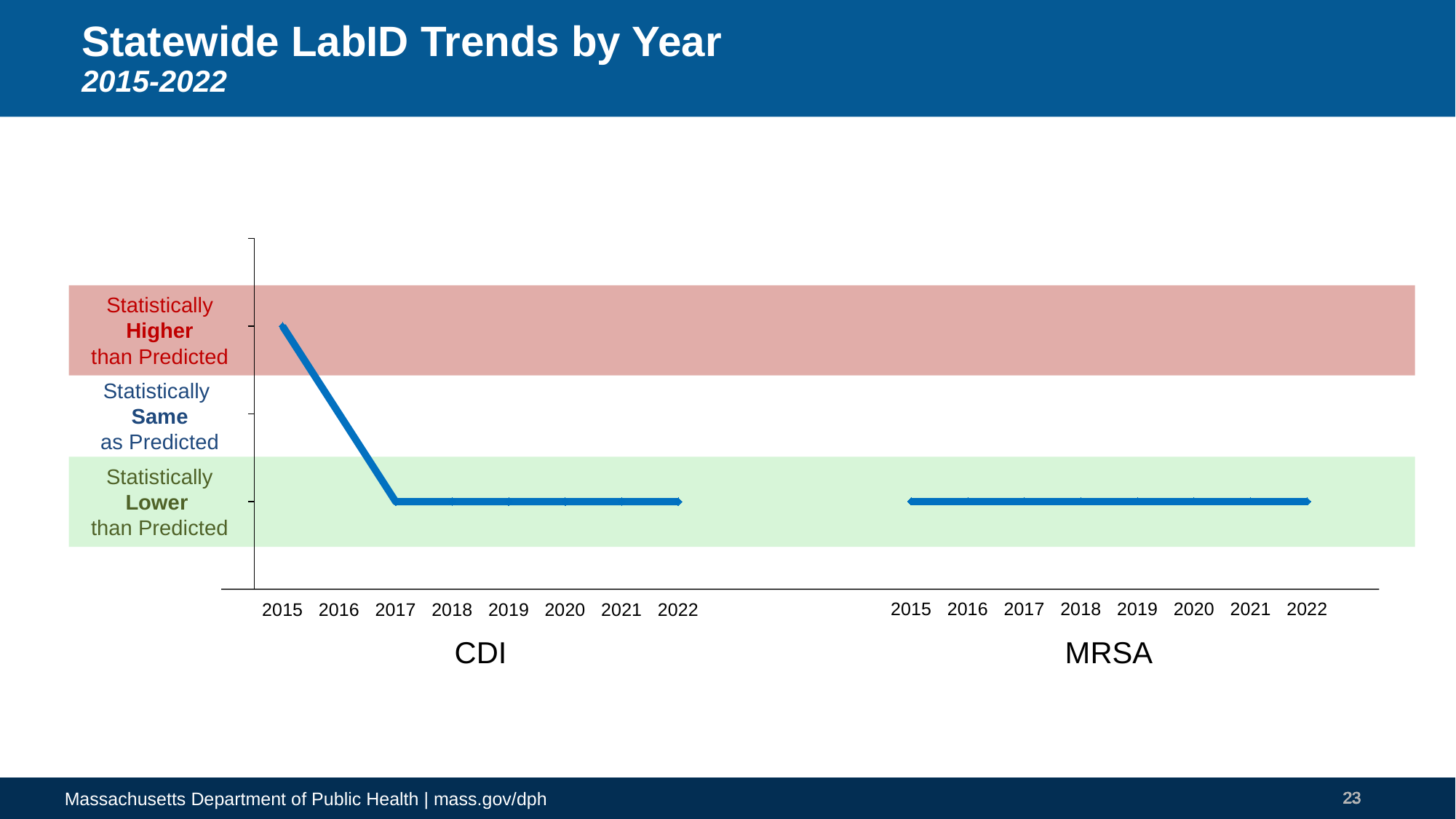
What kind of chart is shown on the slide? line chart What is the title of the slide? Statewide LabID Trends by Year In the CDI chart, which category does the 2017 value fall in? Statistically Lower than Predicted How many years are plotted on the x axis of the CDI chart? 8 Which is higher: the CDI value for 2015 or the MRSA value for 2015? CDI 2015 In the CDI chart, which category does the 2022 value fall in? Statistically Lower than Predicted In the MRSA chart, which category does the 2015 value fall in? Statistically Lower than Predicted In the MRSA chart, do the values rise, fall, or stay flat from 2015 to 2022? stay flat In the CDI chart, do the values rise or fall from 2015 to 2017? fall In the CDI chart, which year has the highest value? 2015 In the MRSA chart, which category does the 2022 value fall in? Statistically Lower than Predicted In the CDI chart, which category does the 2015 value fall in? Statistically Higher than Predicted